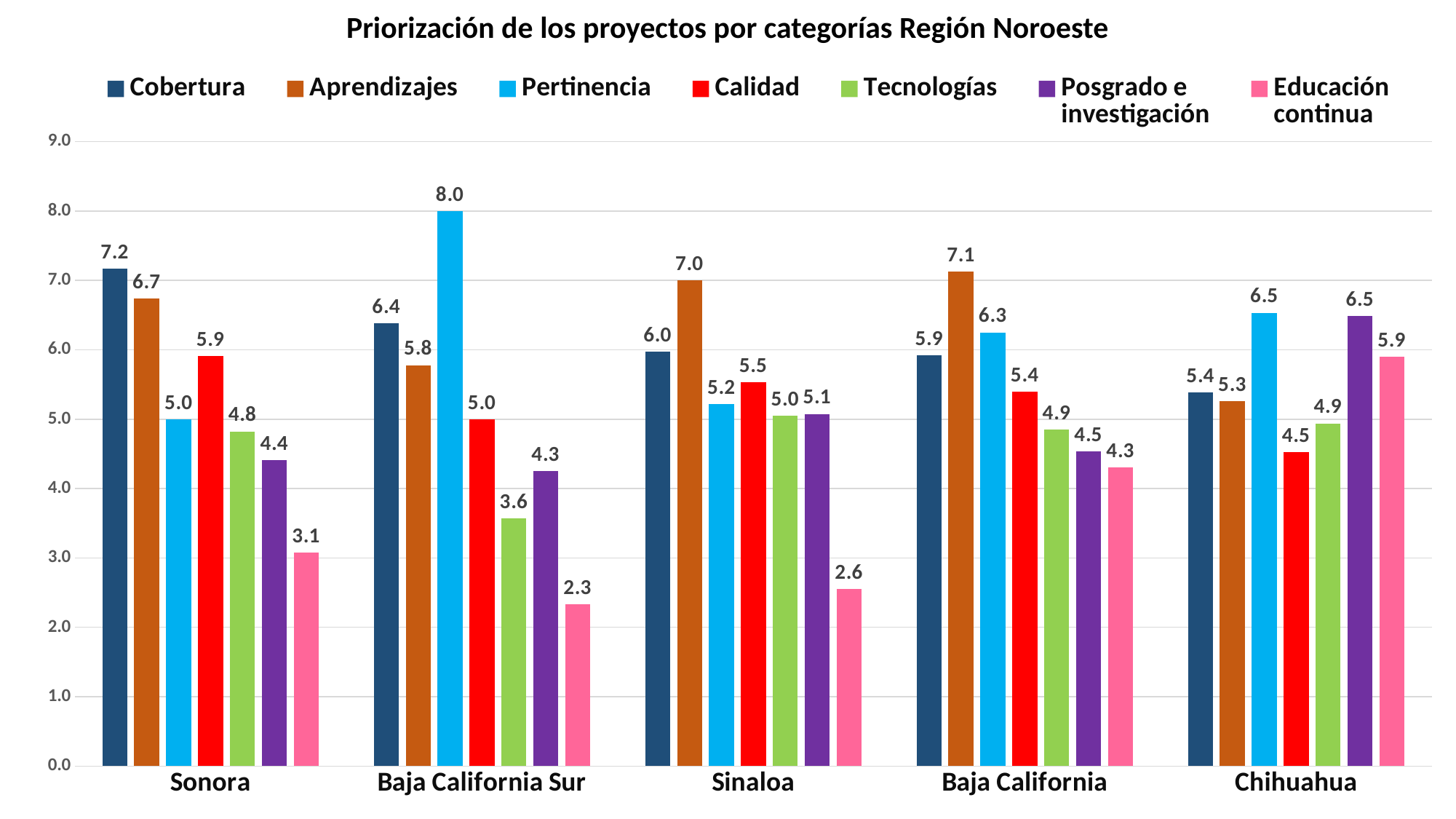
How many series does the legend list? 7 Which is larger, the Calidad value for Sonora or the Calidad value for Sinaloa? Sonora What is the value for Pertinencia in Baja California Sur? 8.0 What is the difference between the Cobertura value for Sonora and the Cobertura value for Chihuahua? 1.8 What is the title of the chart? Priorización de los proyectos por categorías Región Noroeste What kind of chart is shown on the slide? Bar chart What is the value for Posgrado e investigación in Chihuahua? 6.5 Which category has the highest Aprendizajes value? Baja California Which category has the lowest Educación continua value? Baja California Sur What is the value for Educación continua in Sinaloa? 2.6 What is the value for Cobertura in Sonora? 7.2 How many categories are shown on the x axis? 5